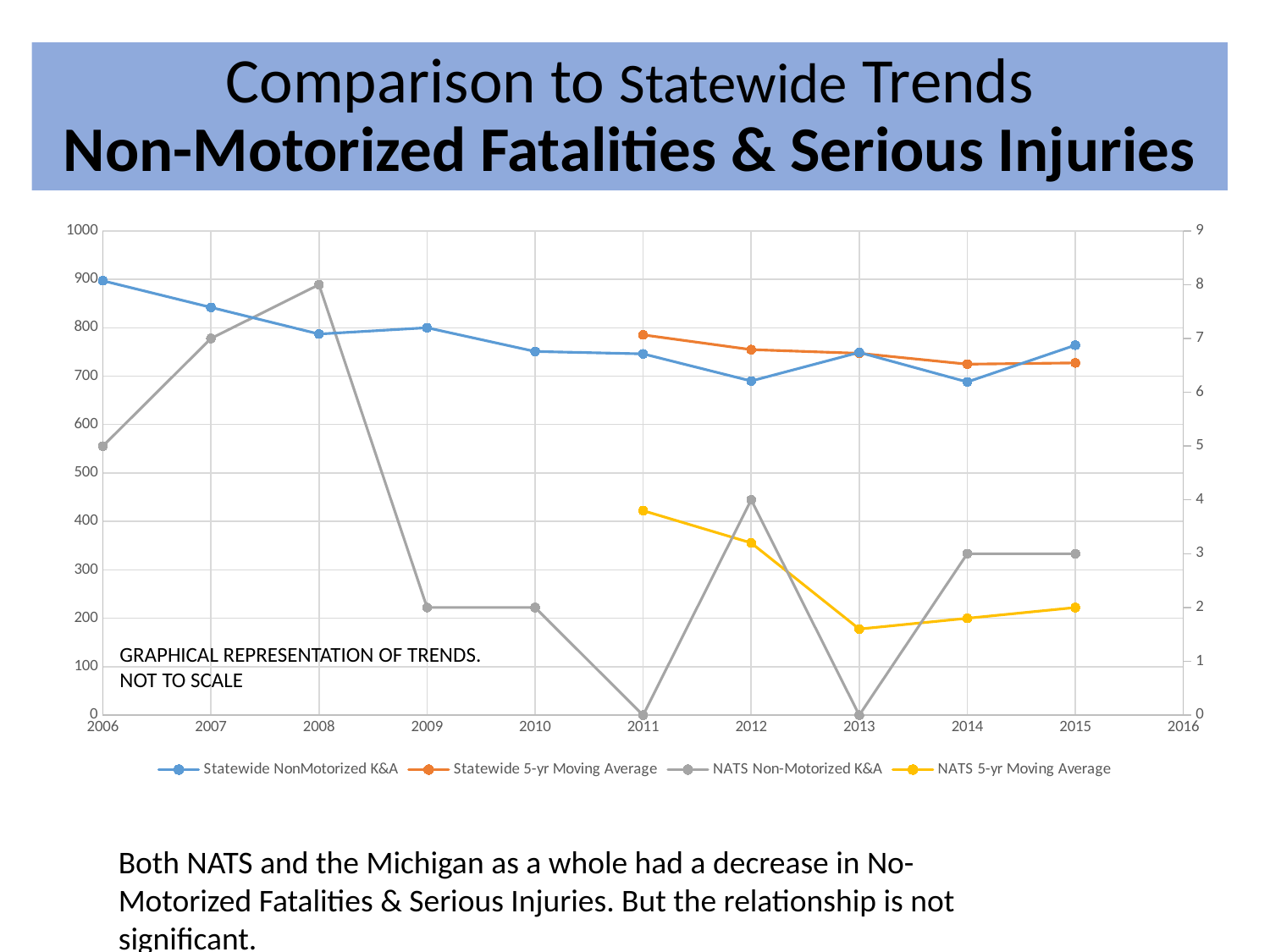
In which year is the Statewide NonMotorized K&A series at its highest? 2006 How many series does the legend list? 4 What kind of chart is shown on the slide? line chart What is the value of NATS Non-Motorized K&A in 2013 on the right-hand axis? 0 Which series is drawn in yellow? NATS 5-yr Moving Average Is the Statewide NonMotorized K&A value for 2012 greater or less than 700? less Which is larger: the Statewide NonMotorized K&A value in 2006 or in 2015? 2006 In which year is the NATS Non-Motorized K&A series at its highest? 2008 What is the value of NATS Non-Motorized K&A in 2011 on the right-hand axis? 0 How many data points does the Statewide 5-yr Moving Average series have? 5 Does the Statewide 5-yr Moving Average rise or fall from 2011 to 2015? fall Is the Statewide NonMotorized K&A value for 2006 greater or less than 800? greater